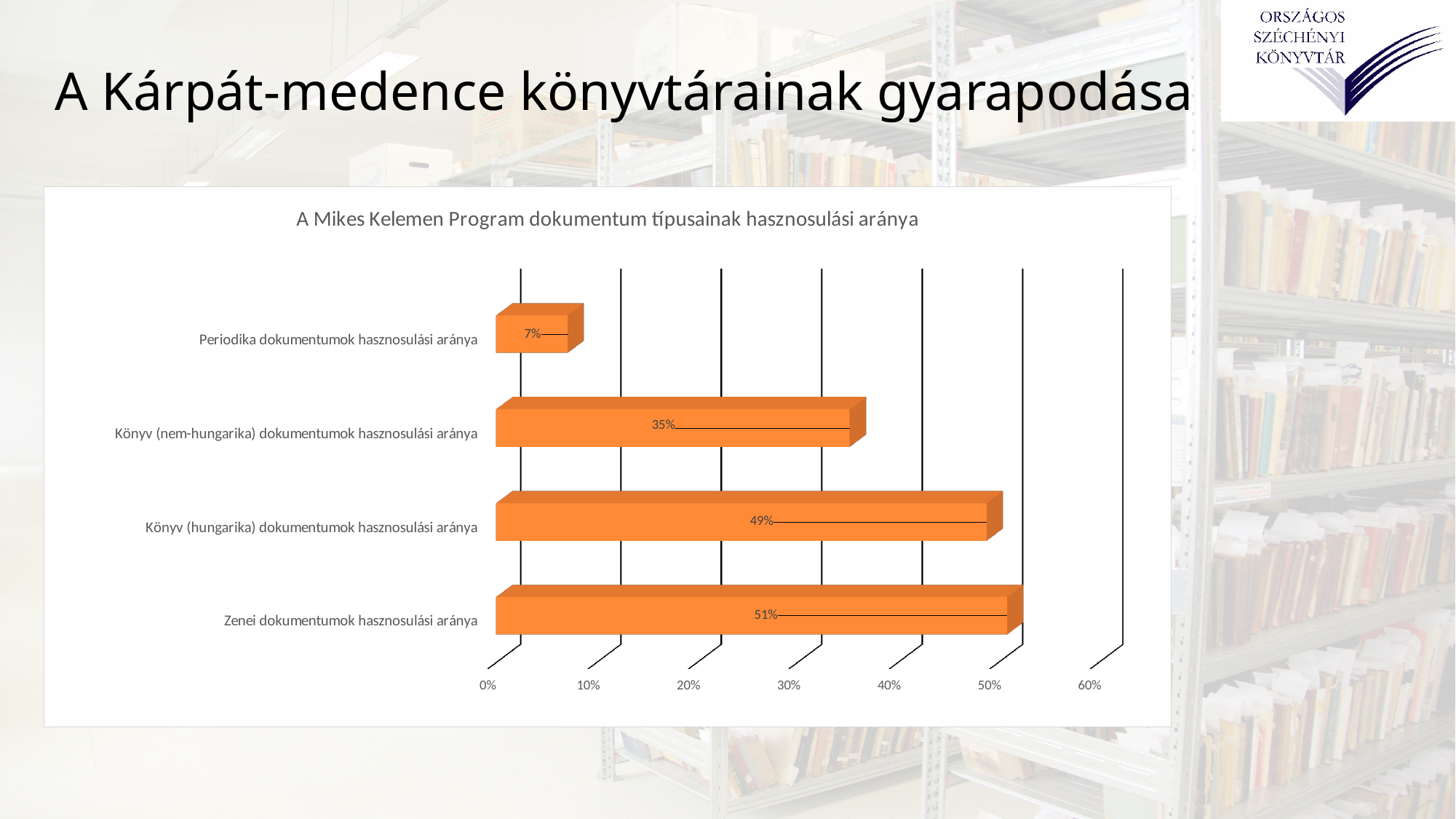
What kind of chart is shown on the slide? Bar chart Which is larger: the value for Könyv (nem-hungarika) dokumentumok or Periodika dokumentumok hasznosulási aránya? Könyv (nem-hungarika) dokumentumok hasznosulási aránya What is the value for Könyv (hungarika) dokumentumok hasznosulási aránya? 49% How many categories are shown in the chart? 4 Which category has the lowest value? Periodika dokumentumok hasznosulási aránya Which category has the highest value? Zenei dokumentumok hasznosulási aránya What is the value for Könyv (nem-hungarika) dokumentumok hasznosulási aránya? 35% What is the value for Zenei dokumentumok hasznosulási aránya? 51% What is the title of the chart? A Mikes Kelemen Program dokumentum típusainak hasznosulási aránya What is the difference between the values for Könyv (hungarika) and Könyv (nem-hungarika) dokumentumok hasznosulási aránya? 14% What is the value for Periodika dokumentumok hasznosulási aránya? 7% What is the difference between the values for Zenei dokumentumok and Periodika dokumentumok hasznosulási aránya? 44%